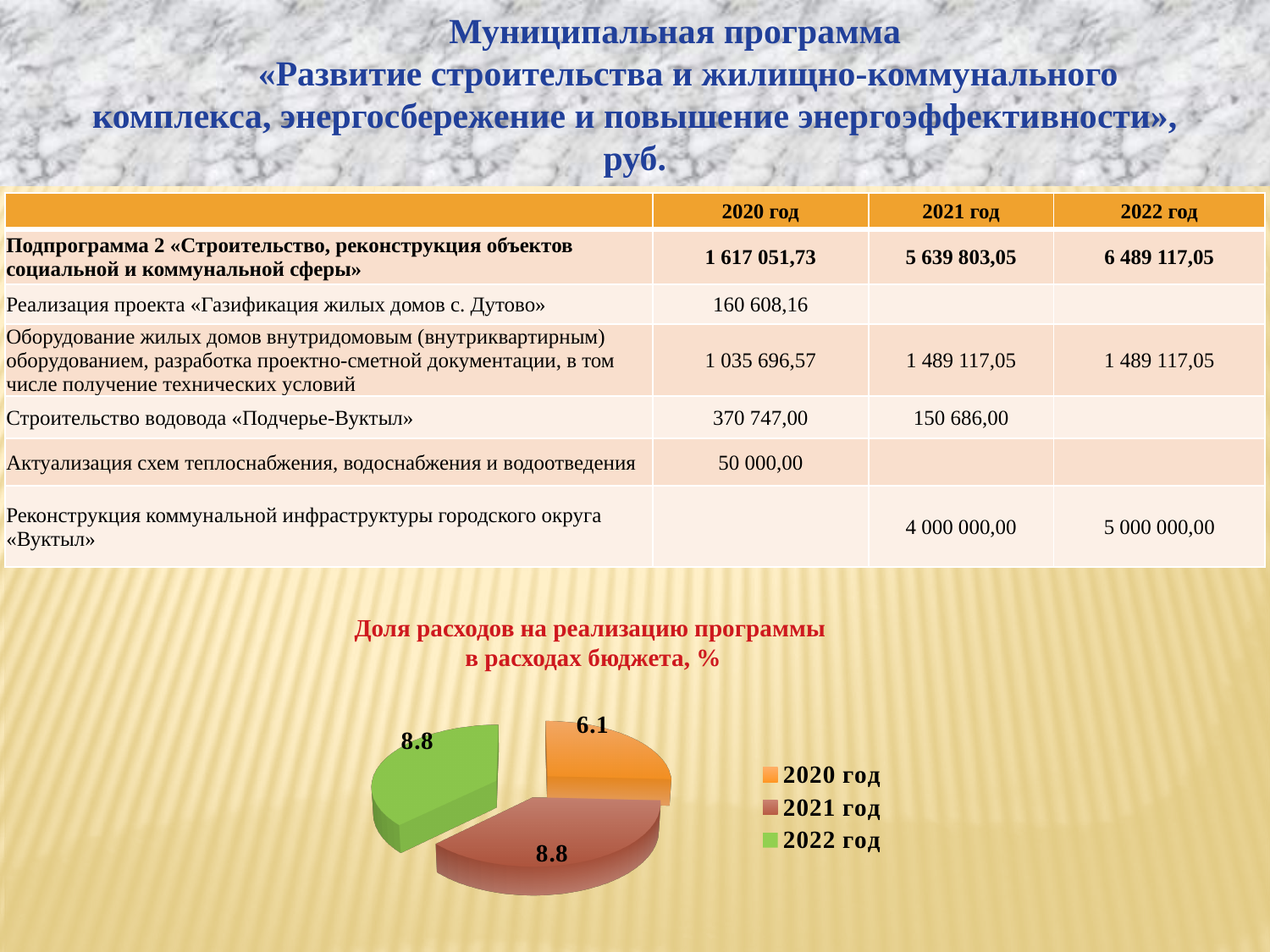
Which is larger in the pie chart, the value for 2020 год or the value for 2021 год? 2021 год What is the title of the pie chart? Доля расходов на реализацию программы в расходах бюджета, % What value is shown for 2021 год in the pie chart? 8.8 How many entries does the legend of the pie chart list? 3 What is the difference between the values for 2021 год and 2020 год in the pie chart? 2.7 What kind of chart is shown on the slide? pie chart How many slices does the pie chart have? 3 What value is shown for 2022 год in the pie chart? 8.8 Which year has the lowest value in the pie chart? 2020 год What value is shown for 2020 год in the pie chart? 6.1 What colour is the slice for 2022 год in the pie chart? green